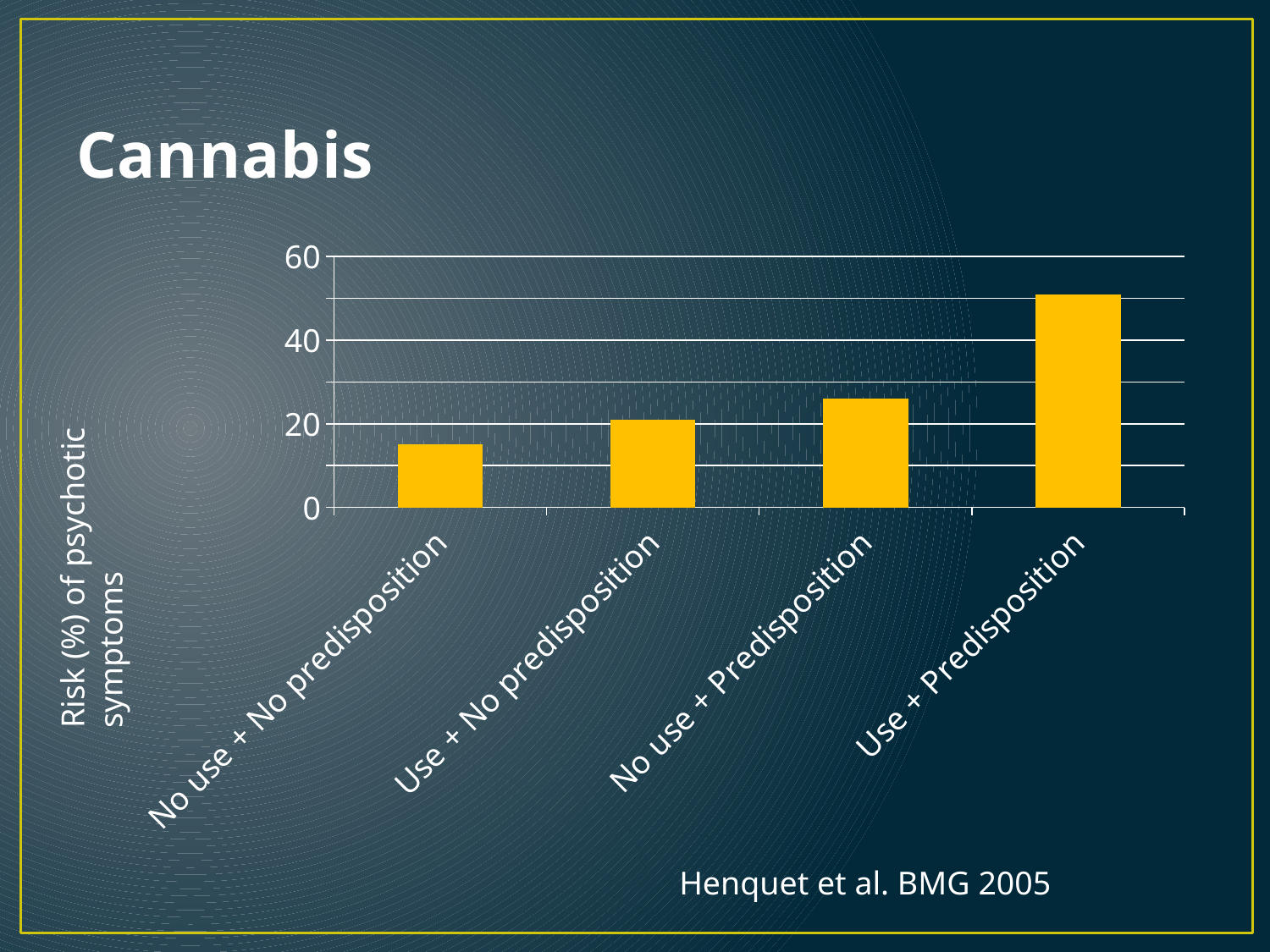
Is the value for No use + Predisposition greater or less than 20? greater Is the value for Use + No predisposition greater or less than 40? less How many categories are shown on the x axis of the chart? 4 Is the value for Use + Predisposition greater or less than 40? greater Which category has the highest risk of psychotic symptoms? Use + Predisposition Which is larger, the value for No use + No predisposition or the value for Use + No predisposition? Use + No predisposition Do the values rise or fall from left to right along the x axis? rise Which category has the lowest risk of psychotic symptoms? No use + No predisposition What is the label on the vertical axis of the chart? Risk (%) of psychotic symptoms What kind of chart is shown on the slide? Bar chart Which is larger, the value for Use + Predisposition or the value for No use + Predisposition? Use + Predisposition